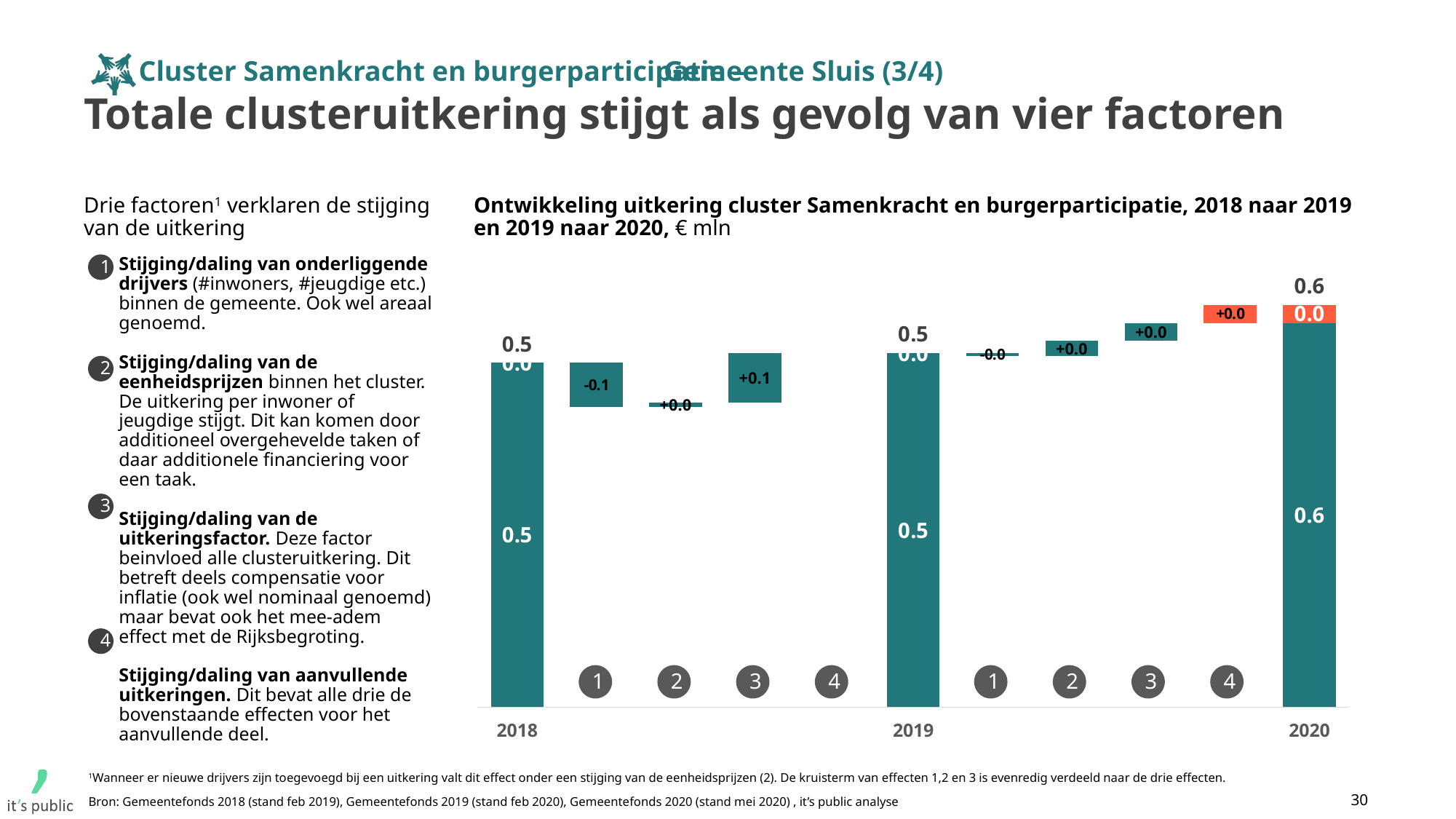
How many year totals are shown in the chart? 3 Which factor in the 2018 to 2019 transition has the lowest value? Factor 1 What is the total cluster payout shown for 2020? 0.6 What is the value of factor 4 in the change from 2019 to 2020? +0.0 In what unit are the values in the chart expressed? € mln What is the total cluster payout shown for 2018? 0.5 What is the difference between the total for 2020 and the total for 2018? 0.1 What is the value of factor 1 in the change from 2018 to 2019? -0.1 Is the total for 2020 larger or smaller than the total for 2019? larger What is the value of factor 3 in the change from 2018 to 2019? +0.1 What kind of chart is shown on the slide? Waterfall bar chart Which year has the highest total cluster payout? 2020